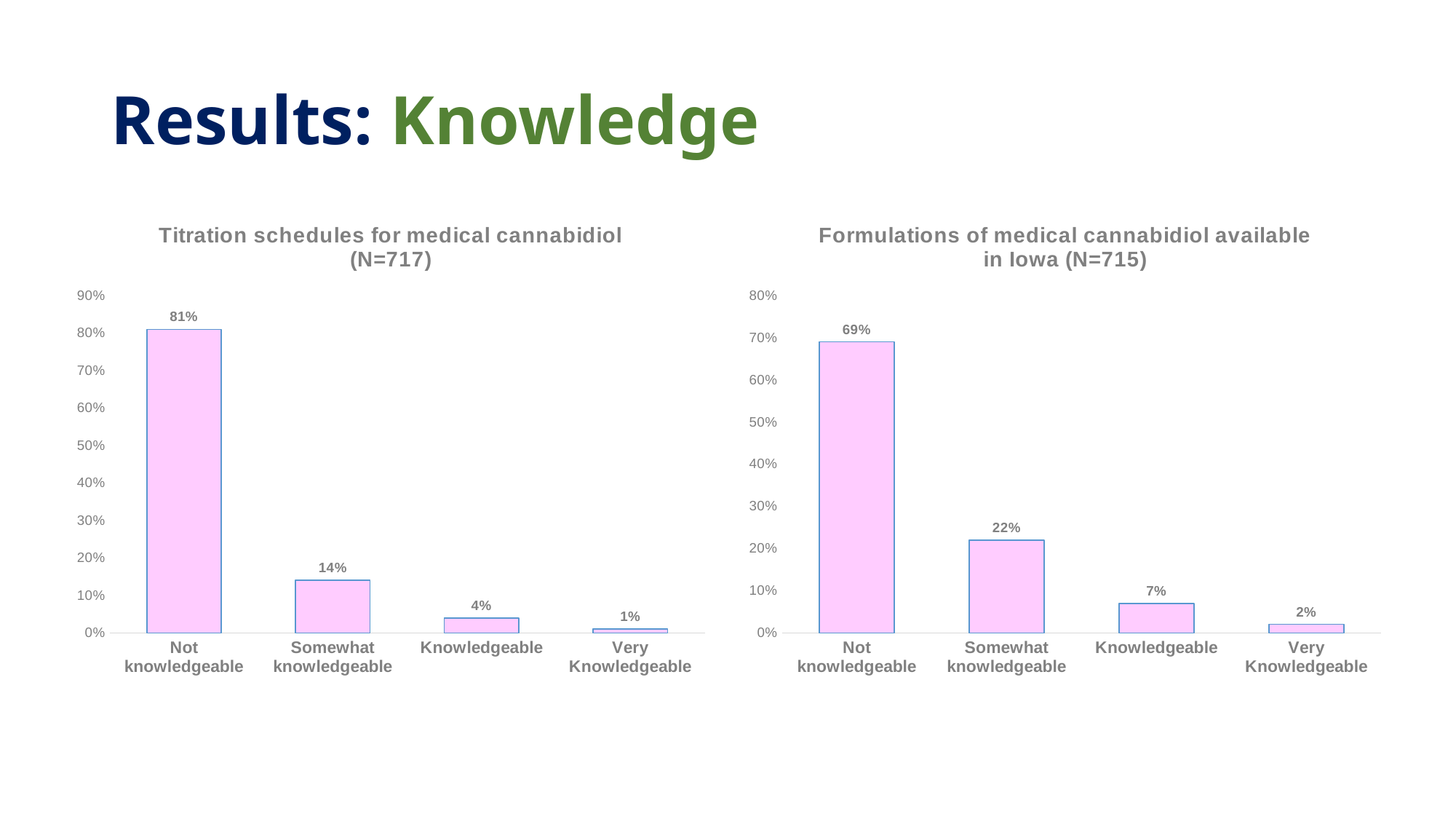
In the 'Formulations of medical cannabidiol available in Iowa (N=715)' chart, what is the value for Somewhat knowledgeable? 22% What kind of chart is the 'Formulations of medical cannabidiol available in Iowa (N=715)' chart? Bar chart In the 'Titration schedules for medical cannabidiol (N=717)' chart, what is the value for Not knowledgeable? 81% What is the sample size (N) shown in the title of the left chart? 717 In the 'Titration schedules for medical cannabidiol (N=717)' chart, do the values rise or fall from left to right? Fall In the 'Titration schedules for medical cannabidiol (N=717)' chart, what is the difference between Not knowledgeable and Somewhat knowledgeable? 67% In the 'Titration schedules for medical cannabidiol (N=717)' chart, which category has the lowest value? Very Knowledgeable In the 'Formulations of medical cannabidiol available in Iowa (N=715)' chart, what is the difference between Knowledgeable and Very Knowledgeable? 5% How many categories are shown in the 'Titration schedules for medical cannabidiol (N=717)' chart? 4 In the 'Formulations of medical cannabidiol available in Iowa (N=715)' chart, is the value for Not knowledgeable greater or less than 60%? greater In the 'Formulations of medical cannabidiol available in Iowa (N=715)' chart, which category has the highest value? Not knowledgeable Which is larger: Somewhat knowledgeable in the 'Titration schedules' chart or Somewhat knowledgeable in the 'Formulations' chart? Formulations chart